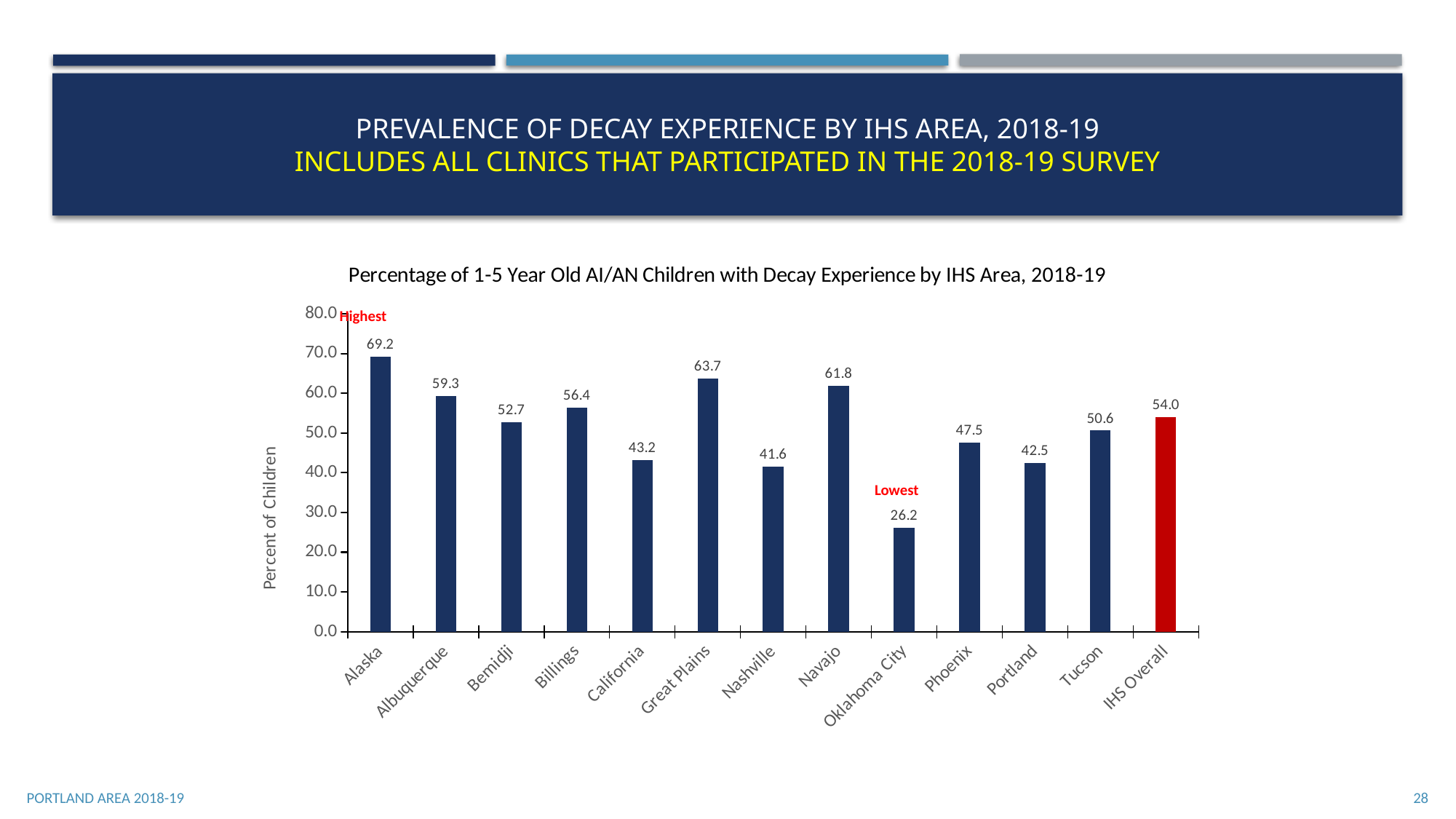
How many categories are shown on the x axis? 13 What is the value for Portland? 42.5 Which IHS area has the highest percentage of children with decay experience? Alaska What kind of chart is shown on the slide? Bar chart Is the value for Nashville greater or less than 50.0? less Which is larger, the value for Great Plains or the value for Navajo? Great Plains What is the value for IHS Overall? 54.0 What is the difference between the values for Alaska and Oklahoma City? 43.0 Which bar is coloured red instead of dark blue? IHS Overall What is the value for Alaska? 69.2 Which IHS area has the lowest percentage of children with decay experience? Oklahoma City What is the difference between the values for Portland and IHS Overall? 11.5